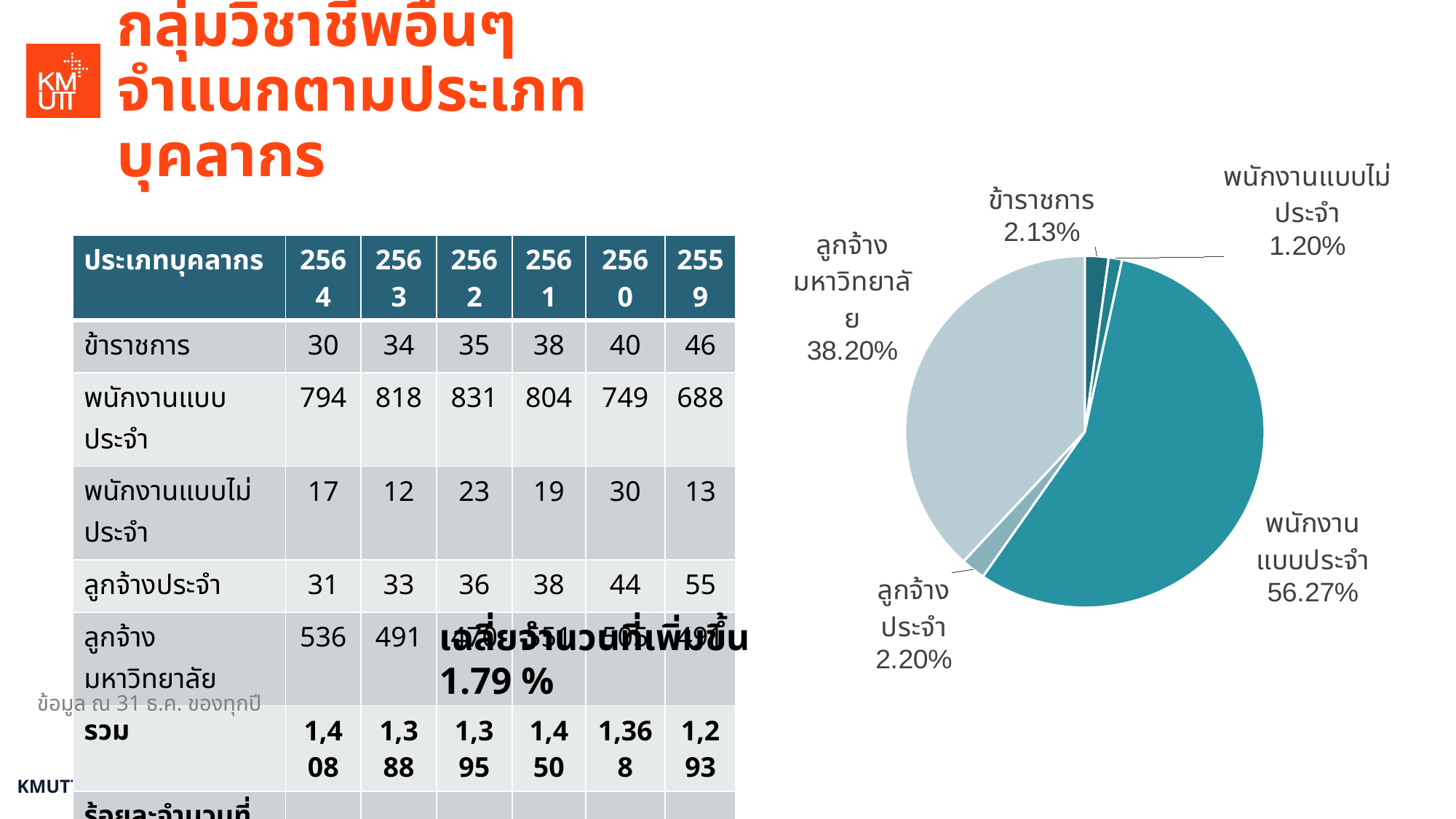
Which category has the largest slice in the pie chart? พนักงานแบบประจำ In the pie chart, which is larger: the share of ลูกจ้างประจำ or the share of ข้าราชการ? ลูกจ้างประจำ In the pie chart, what share does ลูกจ้างมหาวิทยาลัย have? 38.20% How many slices does the pie chart have? 5 What kind of chart is shown on the right side of the slide? pie chart Which category has the smallest slice in the pie chart? พนักงานแบบไม่ประจำ In the pie chart, what is the combined share of ข้าราชการ and พนักงานแบบไม่ประจำ? 3.33% In the pie chart, what is the value shown for พนักงานแบบไม่ประจำ? 1.20% In the pie chart, what is the value shown for ลูกจ้างประจำ? 2.20% In the pie chart, what share does พนักงานแบบประจำ have? 56.27% In the pie chart, what is the value shown for ข้าราชการ? 2.13% In the pie chart, what is the difference between the shares of พนักงานแบบประจำ and ลูกจ้างมหาวิทยาลัย? 18.07%